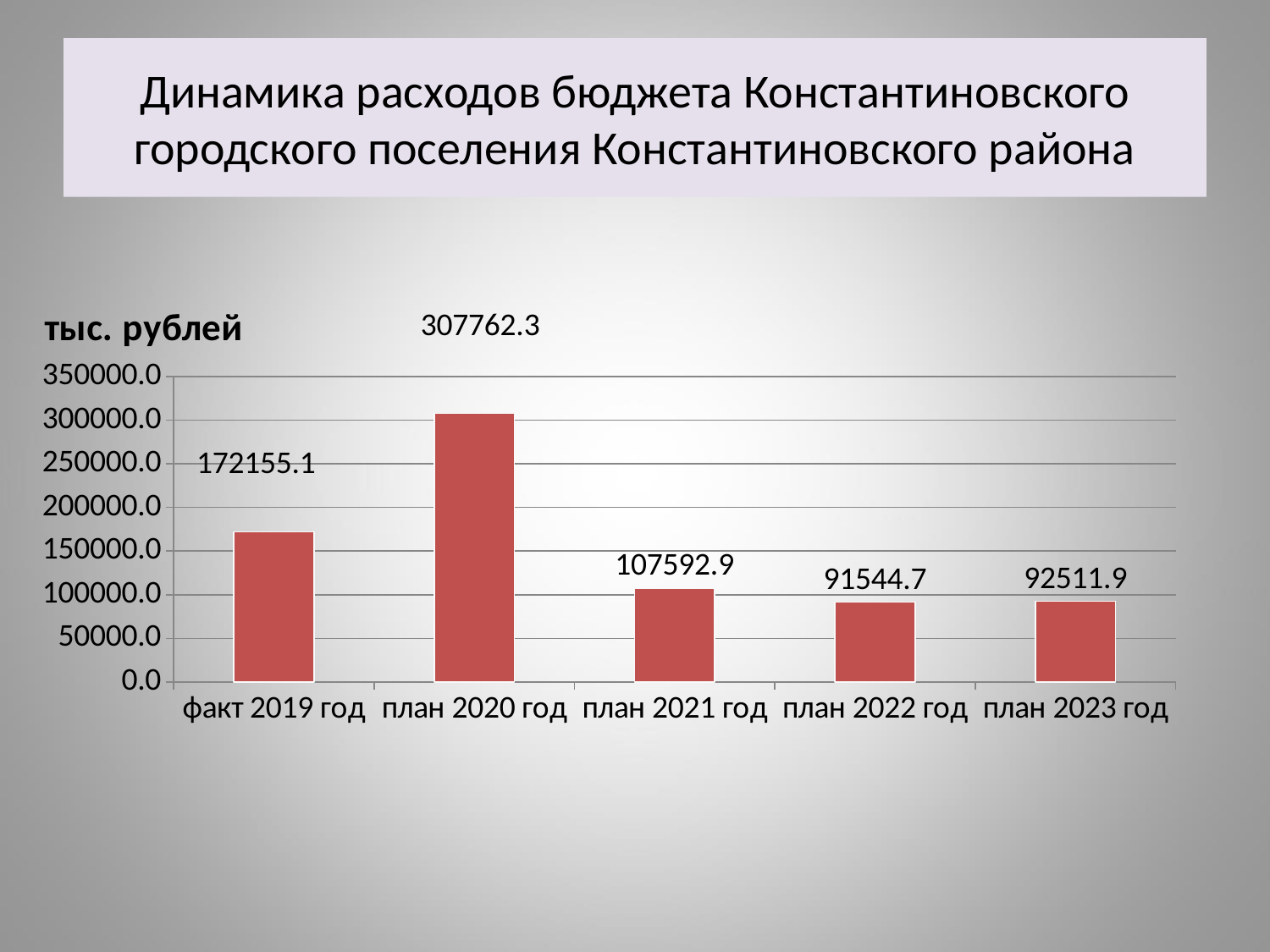
What is the difference between the values for план 2021 год and план 2022 год? 16048.2 Which category has the highest value? план 2020 год What is the value for план 2022 год? 91544.7 Which category has the lowest value? план 2022 год What is the difference between the values for план 2020 год and факт 2019 год? 135607.2 What is the value for факт 2019 год? 172155.1 What is the value for план 2023 год? 92511.9 How many categories are shown on the x axis? 5 What is the value for план 2020 год? 307762.3 What kind of chart is shown on the slide? bar chart Is the value for факт 2019 год greater or less than 200000.0? less Which is larger, the value for план 2023 год or план 2022 год? план 2023 год